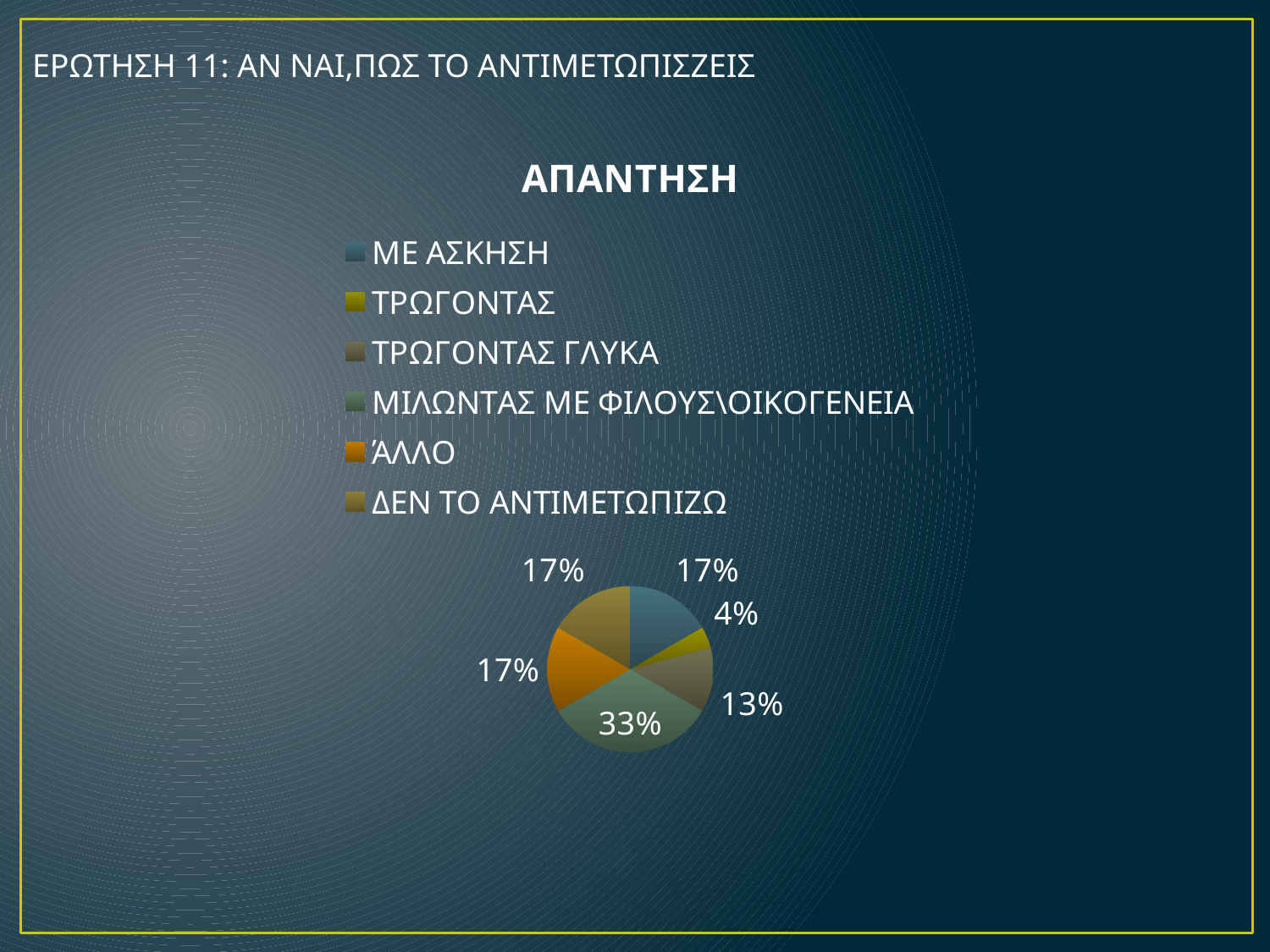
What is the value for ΤΡΩΓΟΝΤΑΣ ΓΛΥΚΑ? 13% How many slices in the pie are labelled 17%? 3 What is the value for ΤΡΩΓΟΝΤΑΣ? 4% What share of the pie does ΜΙΛΩΝΤΑΣ ΜΕ ΦΙΛΟΥΣ\ΟΙΚΟΓΕΝΕΙΑ have? 33% Which category has the smallest slice of the pie? ΤΡΩΓΟΝΤΑΣ How many categories does the legend of the pie chart list? 6 Which category has the largest slice of the pie? ΜΙΛΩΝΤΑΣ ΜΕ ΦΙΛΟΥΣ\ΟΙΚΟΓΕΝΕΙΑ What is the value for ΜΕ ΑΣΚΗΣΗ? 17% What is the difference between the share for ΜΙΛΩΝΤΑΣ ΜΕ ΦΙΛΟΥΣ\ΟΙΚΟΓΕΝΕΙΑ and the share for ΤΡΩΓΟΝΤΑΣ ΓΛΥΚΑ? 20% What is the title of the chart? ΑΠΑΝΤΗΣΗ What kind of chart is shown on the slide? pie chart Which is larger, the share for ΤΡΩΓΟΝΤΑΣ ΓΛΥΚΑ or the share for ΤΡΩΓΟΝΤΑΣ? ΤΡΩΓΟΝΤΑΣ ΓΛΥΚΑ